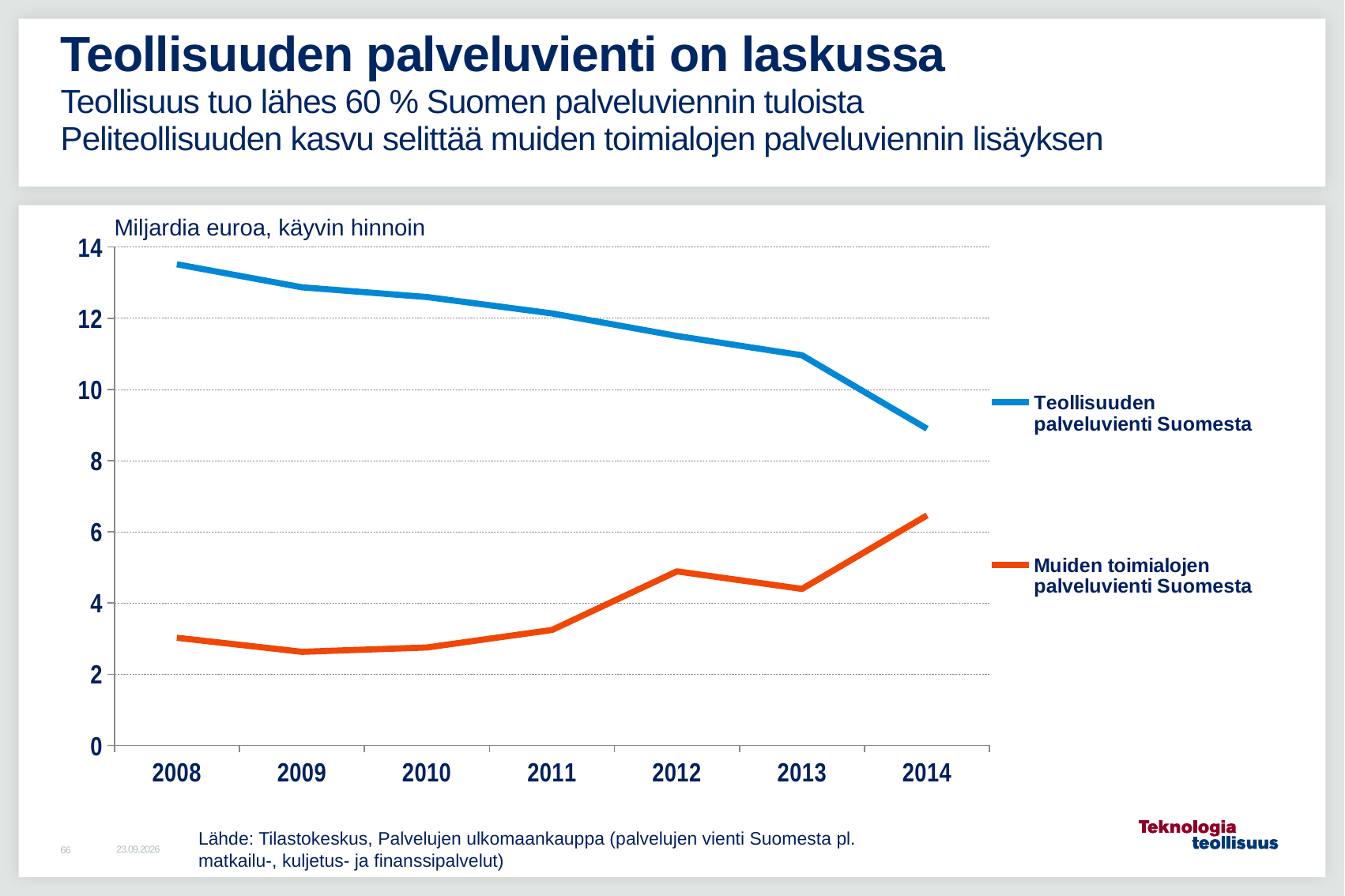
Does the value for Teollisuuden palveluvienti Suomesta rise or fall from 2008 to 2014? fall Does the value for Muiden toimialojen palveluvienti Suomesta rise or fall from 2009 to 2014? rise What kind of chart is shown on the slide? line chart Is the value for Muiden toimialojen palveluvienti Suomesta in 2014 greater or less than 6? greater What unit is stated above the chart's y axis? Miljardia euroa, käyvin hinnoin In which year is Muiden toimialojen palveluvienti Suomesta highest? 2014 How many series does the legend list? 2 In which year is Teollisuuden palveluvienti Suomesta lowest? 2014 In 2014, which series has the larger value: Teollisuuden palveluvienti Suomesta or Muiden toimialojen palveluvienti Suomesta? Teollisuuden palveluvienti Suomesta Is the value for Teollisuuden palveluvienti Suomesta in 2014 greater or less than 10? less In which year is Teollisuuden palveluvienti Suomesta highest? 2008 How many years are plotted along the x axis? 7